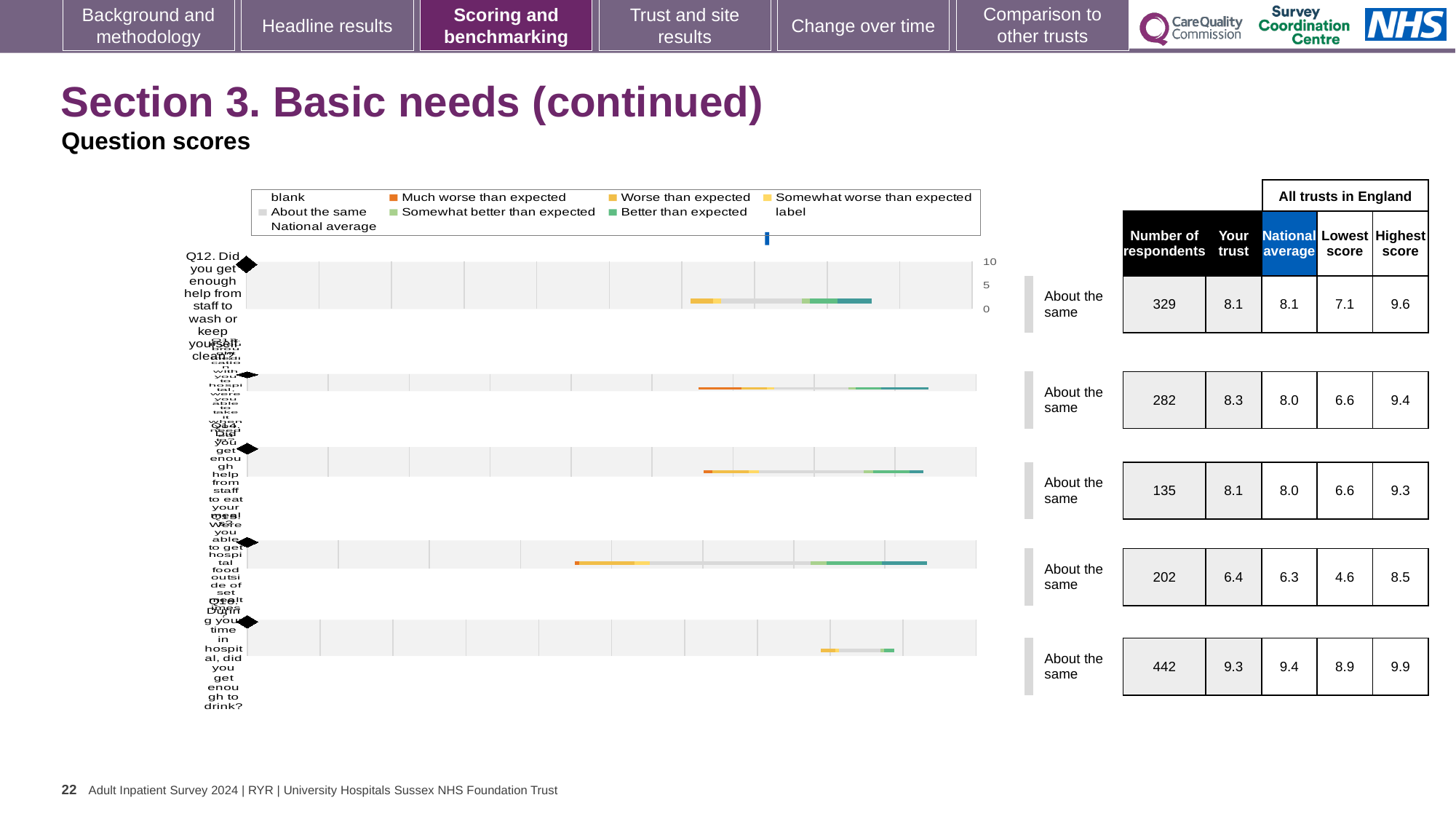
What benchmark category is shown for every question bar in the chart? About the same What is the 'Your trust' score shown for the last question bar (Q16, did you get enough to drink?)? 9.3 What is the 'Your trust' score shown for Q12 (Did you get enough help from staff to wash or keep yourself clean?)? 8.1 Which question bar has the lowest 'Your trust' score? Q15 (hospital food outside of set meal times) What is the difference between the 'Your trust' score and the national average for the fourth question bar (Q15, hospital food outside of set meal times)? 0.1 How many respondents are shown for Q12 (help from staff to wash or keep yourself clean)? 329 How many question bars are plotted in the chart? 5 Which legend entry is shown in orange? Much worse than expected Which question bar has the highest 'Your trust' score? Q16 (did you get enough to drink?) What kind of chart is shown on the slide? bar chart What is the highest score across all trusts in England shown for the last question bar (Q16, did you get enough to drink?)? 9.9 What is the national average shown for Q12 (help from staff to wash or keep yourself clean)? 8.1